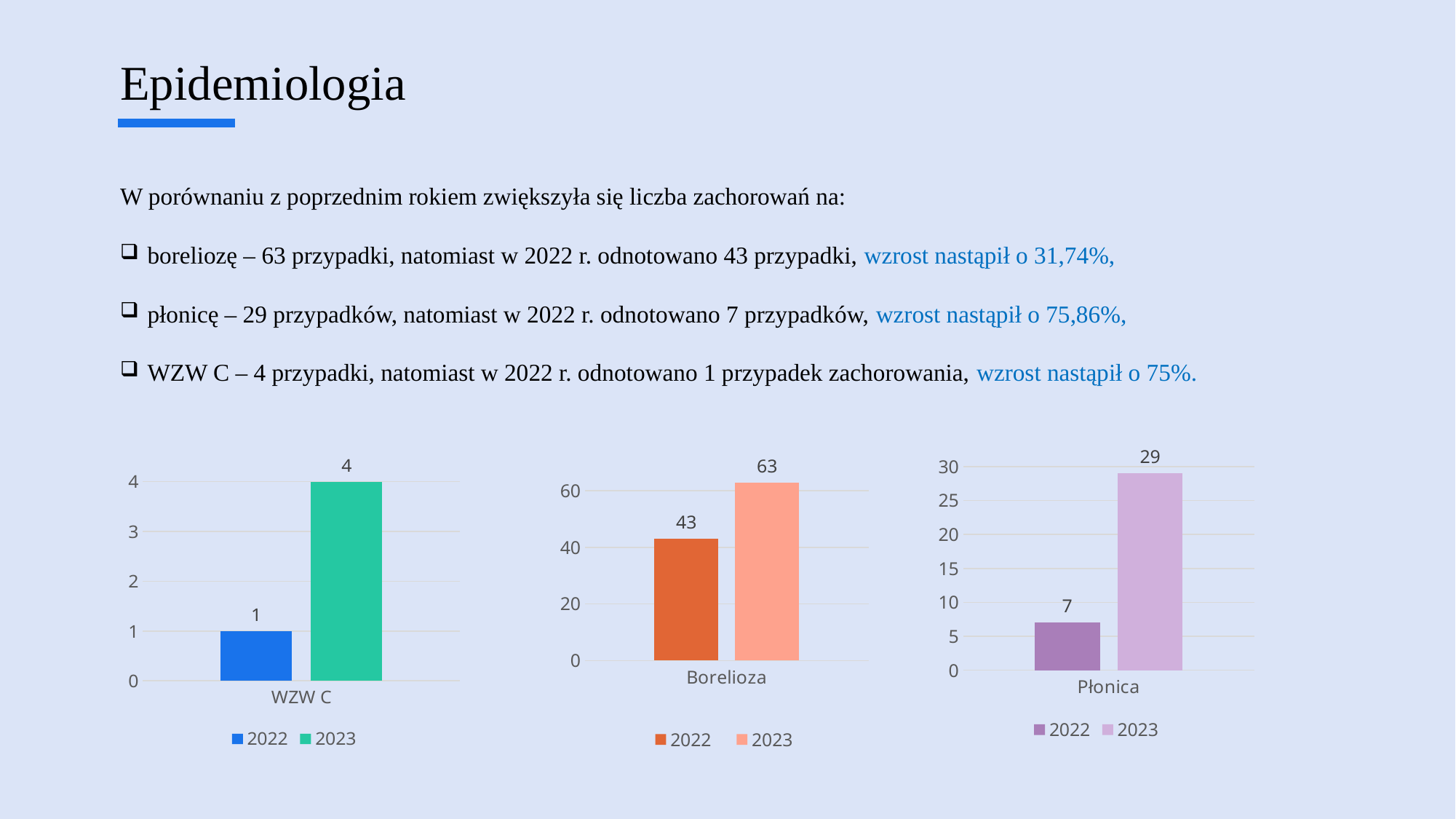
What kind of chart is the right chart (Płonica)? bar chart In the right chart (Płonica), is the value for 2022 greater or less than 10? less In the right chart (Płonica), what is the difference between the 2023 and 2022 values? 22 In the left chart (WZW C), which series has the higher value, 2022 or 2023? 2023 In the middle chart (Borelioza), what is the value for 2022? 43 What is the category label shown on the x axis of the middle chart? Borelioza In the right chart (Płonica), what is the value for 2023? 29 In the left chart (WZW C), what is the value for 2023? 4 In the left chart (WZW C), what is the value for 2022? 1 In the middle chart (Borelioza), what is the value for 2023? 63 In the middle chart (Borelioza), what is the difference between the 2023 and 2022 values? 20 How many series does the legend of the middle chart (Borelioza) list? 2